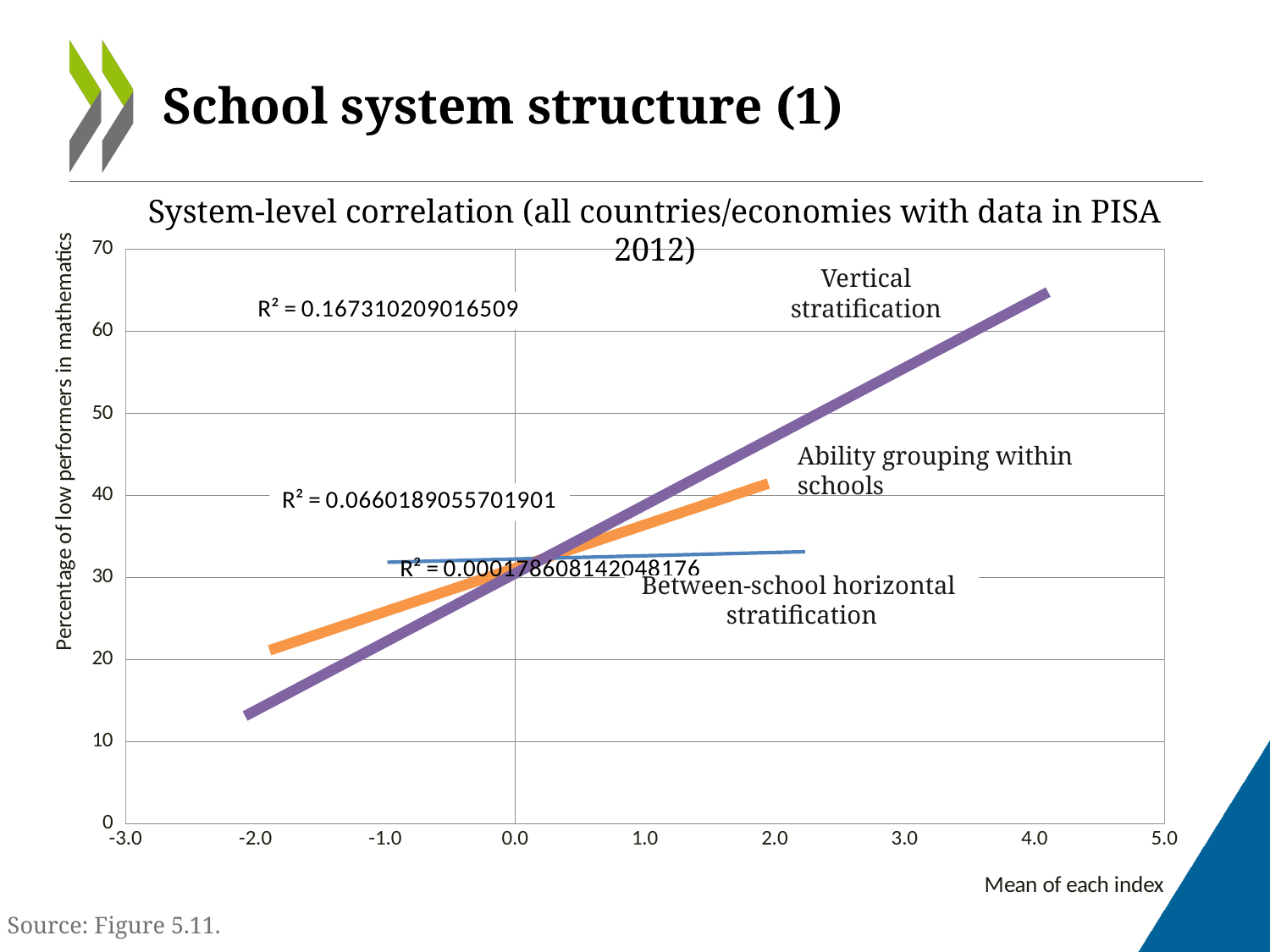
Which line has the highest R² value? Vertical stratification Is the value of the Ability grouping within schools line at a mean index of -1.0 greater or less than 30? less How many trend lines are plotted on the chart? 3 What is the label of the vertical axis? Percentage of low performers in mathematics What is the R² value printed for the Vertical stratification line? R² = 0.167310209016509 What kind of chart is shown on the slide? Line chart Which line has the lowest R² value? Between-school horizontal stratification What is the label of the horizontal axis? Mean of each index What is the R² value printed for the Between-school horizontal stratification line? R² = 0.000178608142048176 Is the value of the Vertical stratification line at a mean index of 4.0 greater or less than 60? greater Does the Vertical stratification line rise or fall as the mean of the index increases? Rises What is the R² value printed for the Ability grouping within schools line? R² = 0.0660189055701901